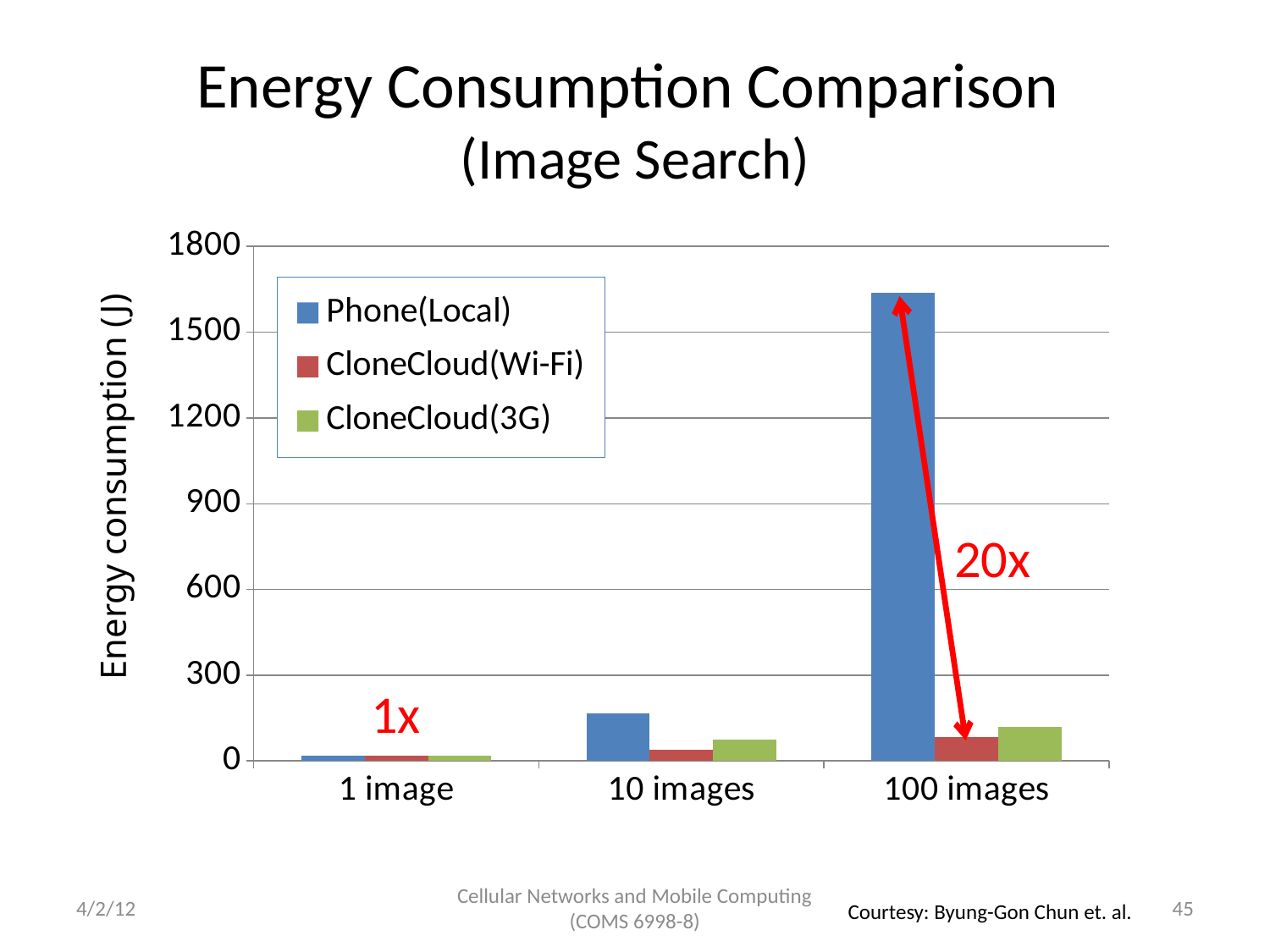
What is the label of the y axis? Energy consumption (J) Does the Phone(Local) energy consumption rise or fall as the number of images increases along the x axis? rise For 100 images, which series has the larger value: CloneCloud(3G) or CloneCloud(Wi-Fi)? CloneCloud(3G) How many series does the legend list? 3 Is the CloneCloud(3G) value for 100 images greater or less than 300? less Is the Phone(Local) value for 10 images greater or less than 300? less Which category has the highest Phone(Local) energy consumption? 100 images What kind of chart is shown on the slide? bar chart For 100 images, which series has the larger value: Phone(Local) or CloneCloud(Wi-Fi)? Phone(Local) Is the Phone(Local) value for 100 images greater or less than 1500? greater Which category has the lowest Phone(Local) energy consumption? 1 image How many categories are shown on the x axis? 3